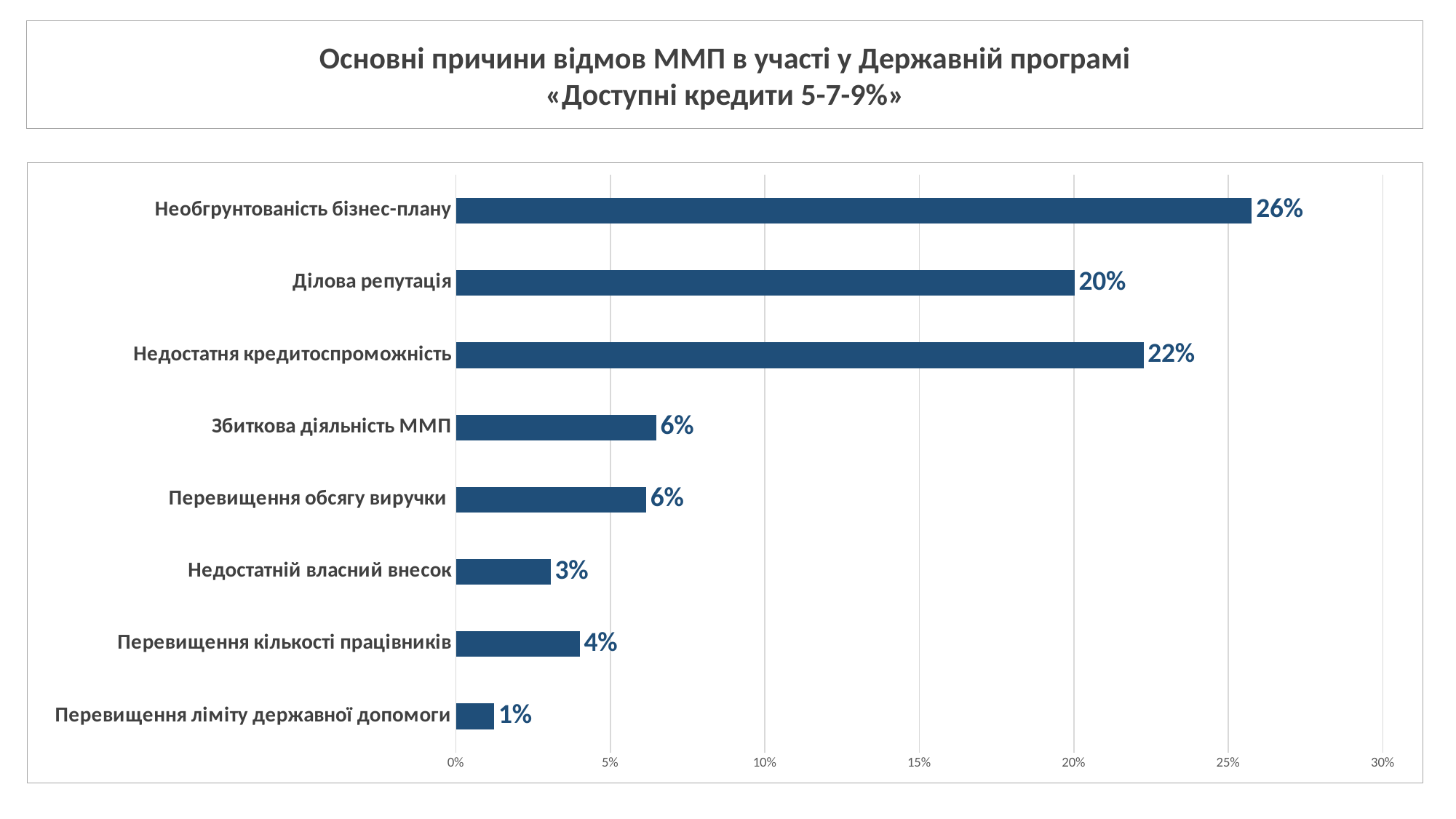
What is the value for Перевищення ліміту державної допомоги? 1% Is the value for Недостатня кредитоспроможність greater or less than 20%? greater What is the value for Недостатня кредитоспроможність? 22% What is the value for Недостатній власний внесок? 3% Which category has the lowest value? Перевищення ліміту державної допомоги How many categories are shown in the chart? 8 Which is larger, the value for Недостатня кредитоспроможність or the value for Ділова репутація? Недостатня кредитоспроможність What is the difference between the values for Необґрунтованість бізнес-плану and Ділова репутація? 6% What is the value for Необґрунтованість бізнес-плану? 26% What kind of chart is shown on the slide? Bar chart What is the value for Ділова репутація? 20% Which category has the highest value? Необґрунтованість бізнес-плану